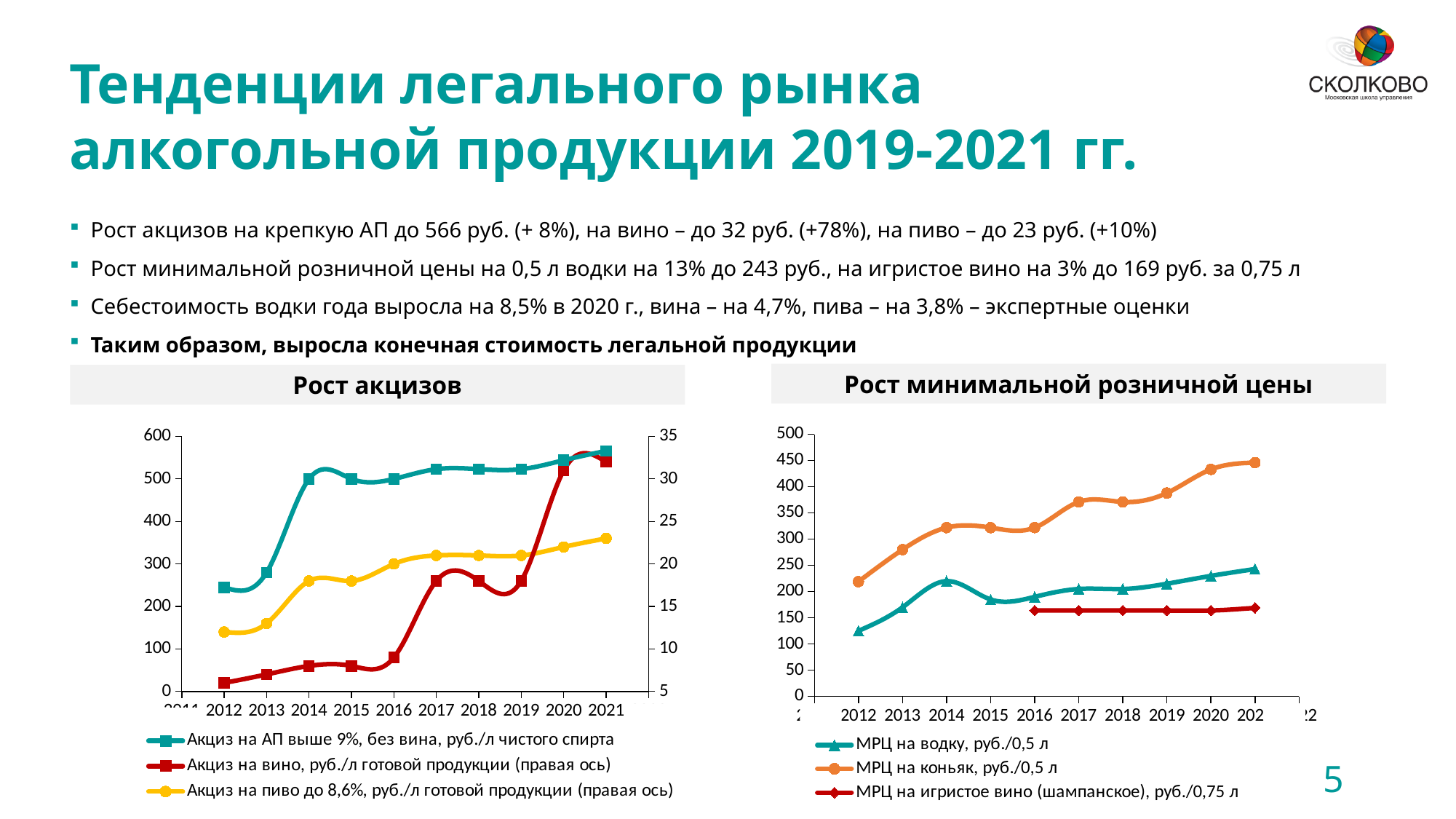
In the "Рост минимальной розничной цены" chart, which series has the lowest value in 2021? МРЦ на игристое вино (шампанское), руб./0,75 л In the "Рост акцизов" chart, does the "Акциз на вино" series rise or fall from 2012 to 2021? rise In the "Рост минимальной розничной цены" chart, does the "МРЦ на коньяк" series rise or fall from 2012 to 2021? rise What is the title of the chart on the left of the slide? Рост акцизов How many series does the legend of the "Рост акцизов" chart list? 3 How many series does the legend of the "Рост минимальной розничной цены" chart list? 3 In the "Рост минимальной розничной цены" chart, which is larger in 2021: "МРЦ на водку" or "МРЦ на коньяк"? МРЦ на коньяк In the "Рост акцизов" chart, is the 2012 value for "Акциз на АП выше 9%, без вина" greater or less than 300? less What kind of chart is the "Рост акцизов" chart? Line chart In the "Рост минимальной розничной цены" chart, is the 2012 value for "МРЦ на водку" greater or less than 150? less How many years are plotted on the "Рост акцизов" chart? 10 In the "Рост минимальной розничной цены" chart, is the 2021 value for "МРЦ на коньяк" greater or less than 400? greater